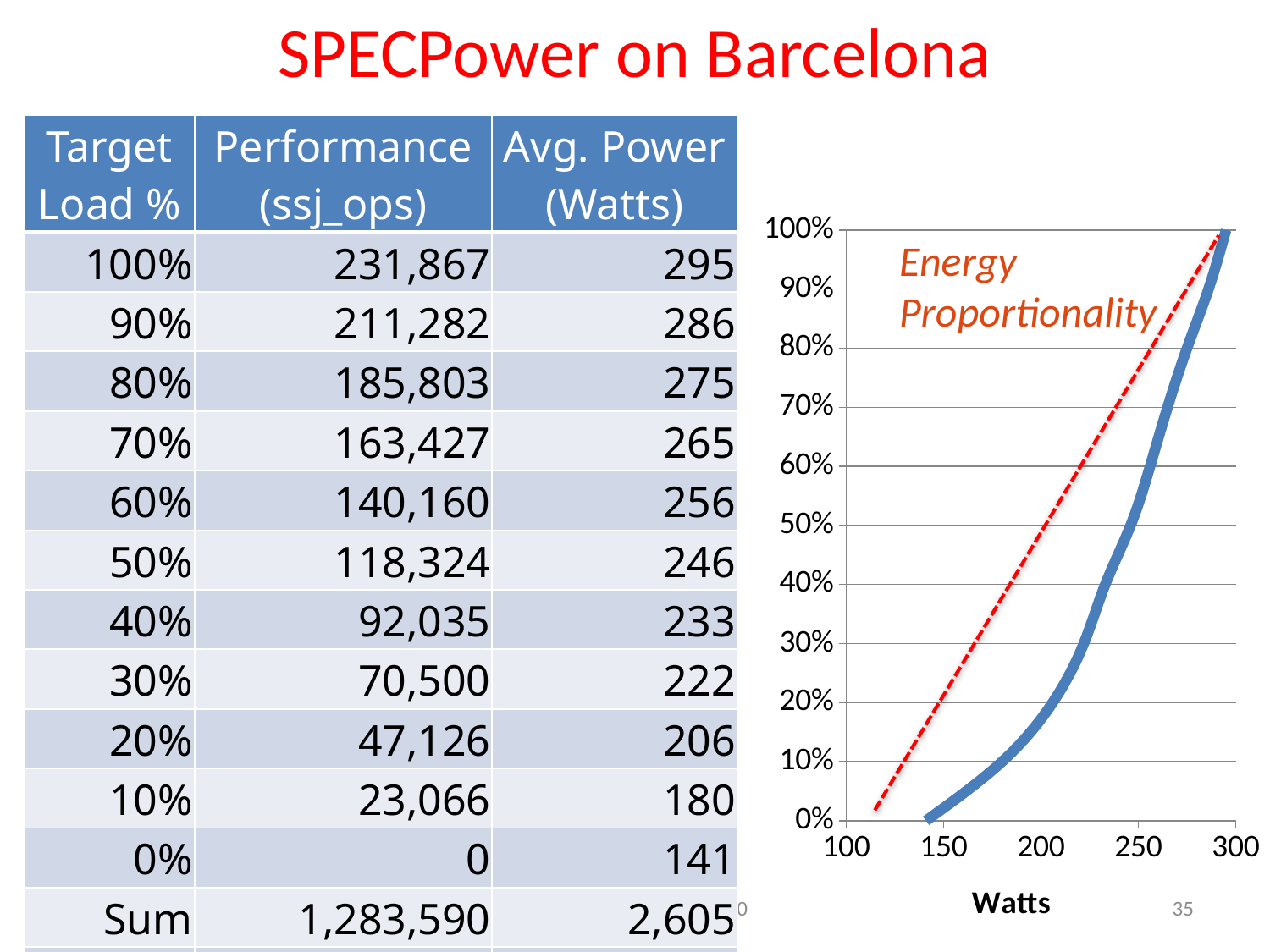
What is the difference in average power (Watts) between 100% and 0% target load? 154 Is the power (Watts) at 100% target load greater or less than 300? less Is the power (Watts) at 50% target load greater or less than 200? greater Does the blue line rise or fall as Watts increase along the x axis? rises Is the power (Watts) at 0% target load greater or less than 150? less What is the average power in Watts at 100% target load? 295 What kind of chart is shown on the right of the slide? line chart Which has higher average power: 60% target load or 40% target load? 60% Which target load has the highest average power? 100% What is the title of the x axis of the chart? Watts What label is written next to the red dashed line in the chart? Energy Proportionality How many target load levels are plotted on the blue line (as listed in the table)? 11